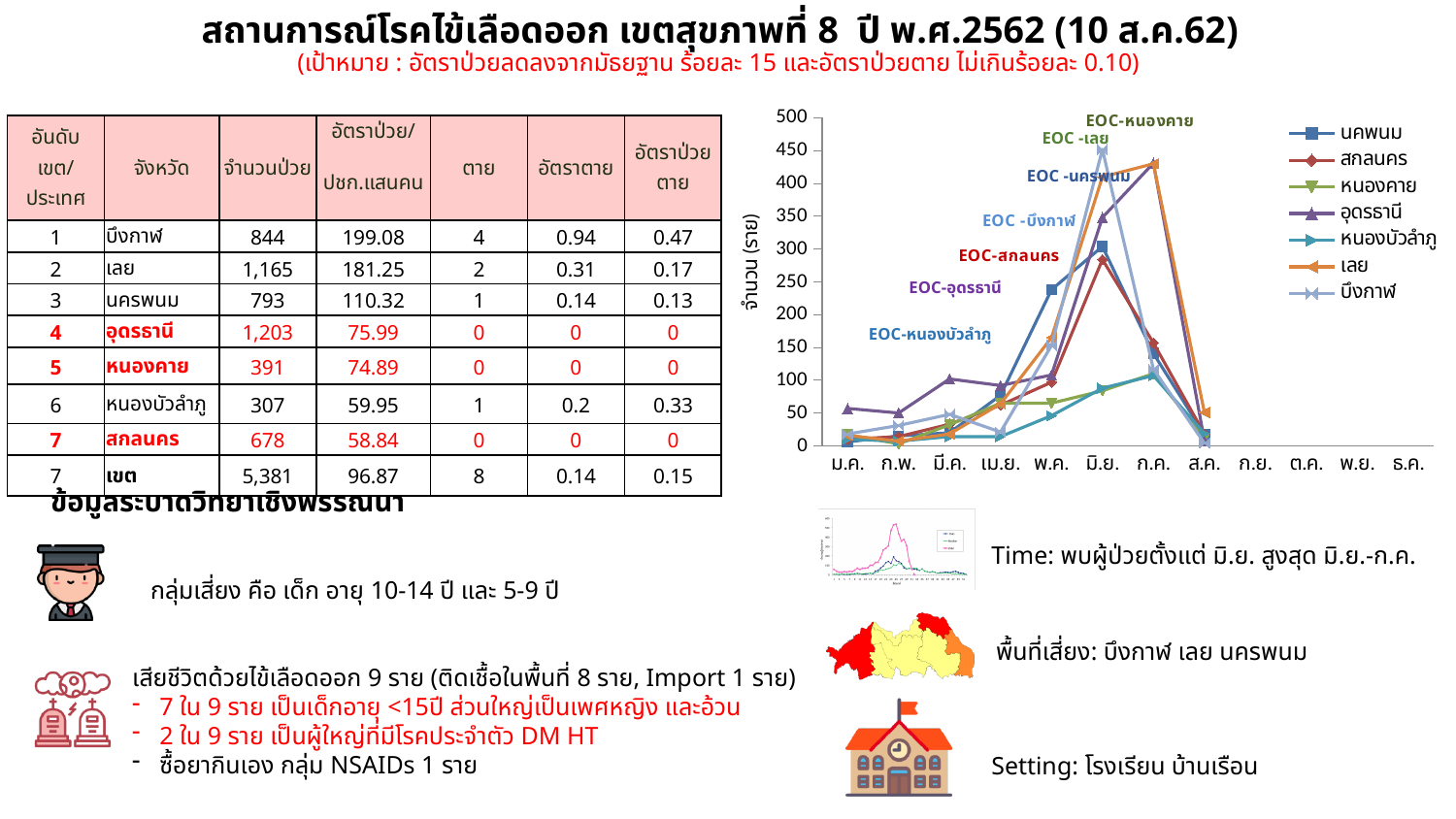
In the line chart, which series has the highest value in มิ.ย.? บึงกาฬ In the line chart, is the value for บึงกาฬ in ก.ค. greater or less than 400? less What kind of chart is shown on the right side of the slide? line chart How many series does the legend of the line chart list? 7 In the line chart, is the value for อุดรธานี in มี.ค. greater or less than 50? greater In the line chart, do the values for เลย rise or fall from ก.ค. to ส.ค.? fall What is the highest tick value shown on the y axis of the line chart? 500 How many months are shown along the x axis of the line chart? 12 In the line chart, is the value for หนองคาย in ก.ค. greater or less than 150? less What is the label on the y axis of the line chart? จำนวน (ราย)